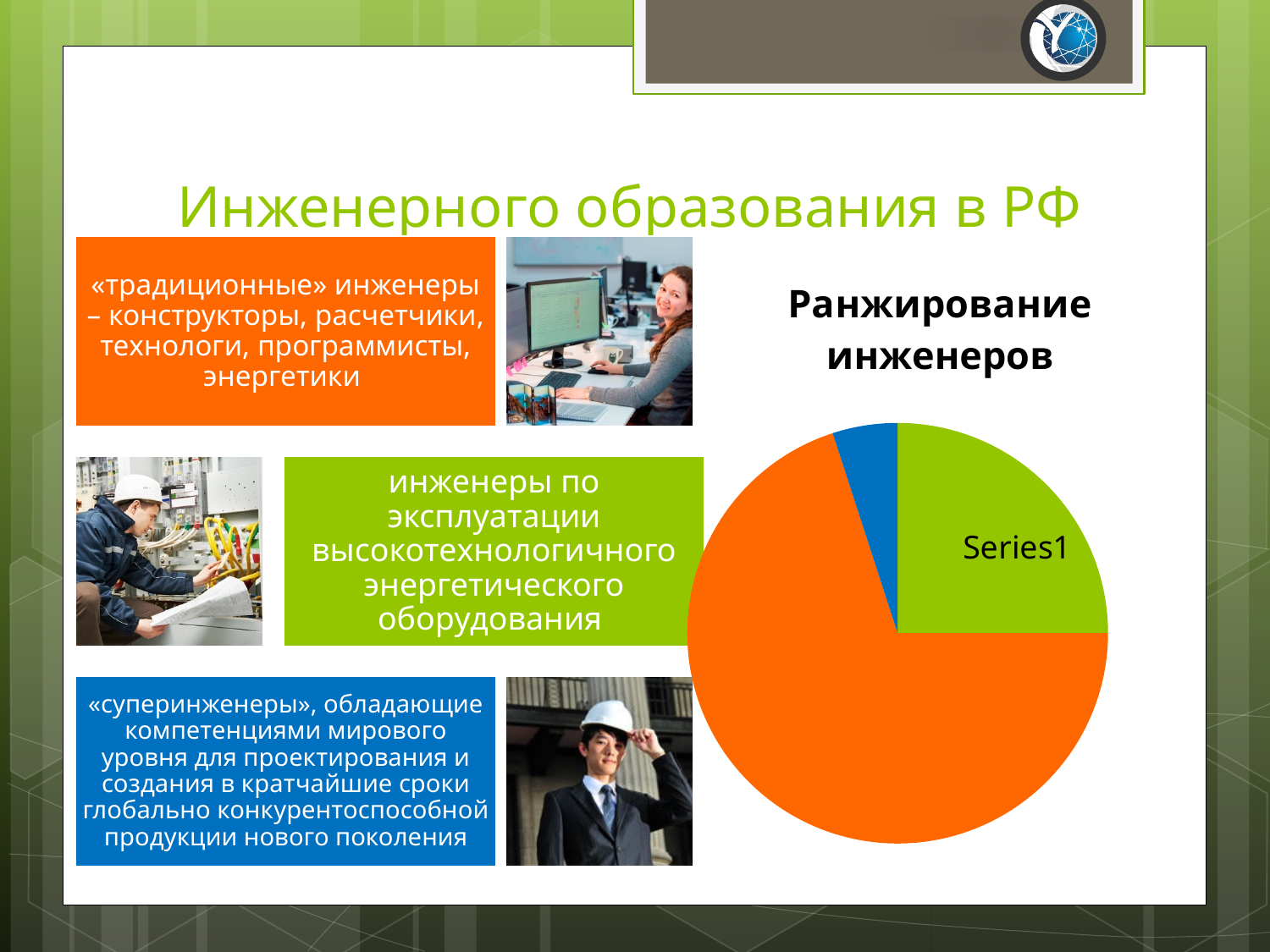
Which colour slice is the largest in the pie chart "Ранжирование инженеров"? orange In the pie chart "Ранжирование инженеров", which is larger, the orange slice or the green slice? orange Which colour slice is the smallest in the pie chart "Ранжирование инженеров"? blue What text label is printed on the green slice of the pie chart "Ранжирование инженеров"? Series1 What kind of chart is shown under the heading "Ранжирование инженеров"? pie chart In the pie chart "Ранжирование инженеров", which is larger, the green slice or the blue slice? green What is the title of the pie chart on the slide? Ранжирование инженеров How many slices does the pie chart "Ранжирование инженеров" have? 3